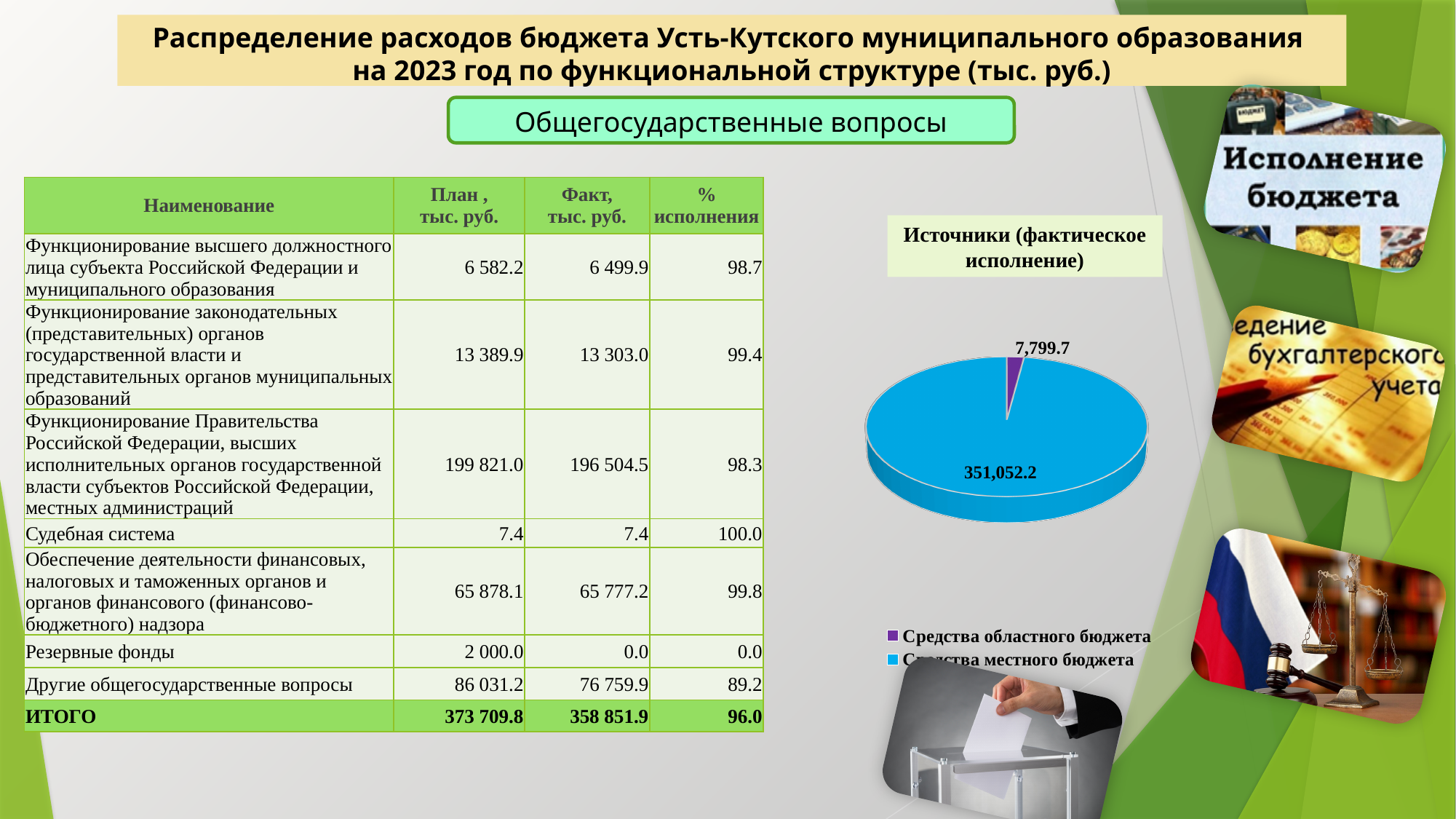
Which slice of the pie chart is the smallest? Средства областного бюджета In the pie chart, which is larger: "Средства областного бюджета" or "Средства местного бюджета"? Средства местного бюджета What kind of chart is shown under the heading "Источники (фактическое исполнение)"? Pie chart In the pie chart, what is the value for "Средства местного бюджета"? 351,052.2 What is the title of the pie chart? Источники (фактическое исполнение) How many entries does the legend of the pie chart list? 2 How many slices does the pie chart have? 2 What colour is the "Средства областного бюджета" slice in the pie chart? Purple In the pie chart, what is the value for "Средства областного бюджета"? 7,799.7 What is the difference between the two slices of the pie chart (351,052.2 and 7,799.7)? 343,252.5 What is the total of the two values shown in the pie chart? 358,851.9 Which slice of the pie chart is the largest? Средства местного бюджета